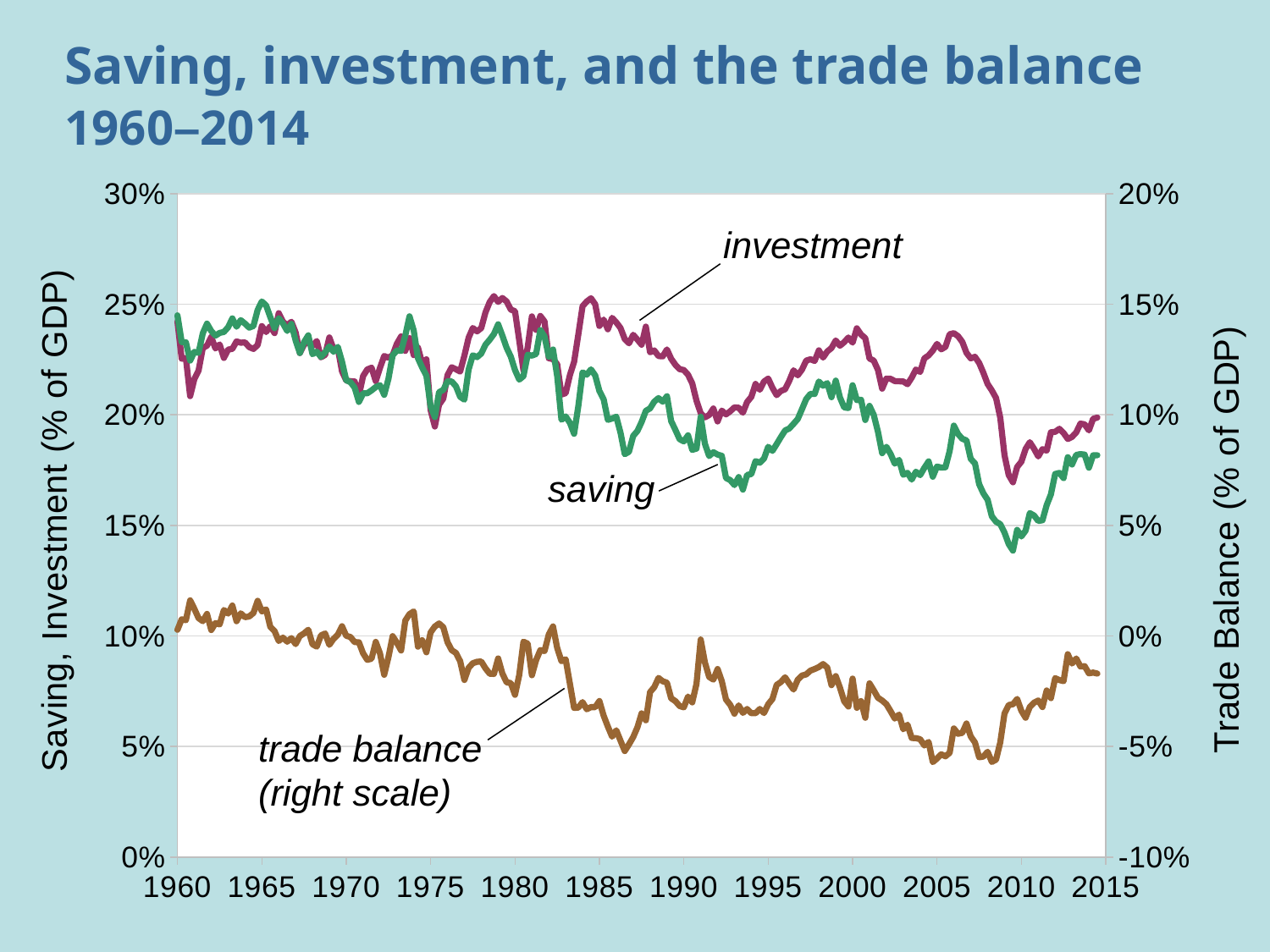
Does the saving series overall rise or fall from 1960 to 2014? fall Which series is plotted against the right scale? trade balance How many series are plotted on the chart? 3 Is the value for trade balance in 1965 greater or less than 0%? greater Is the value for investment in 1960 greater or less than 20%? greater In 2000, which is higher, investment or saving? investment What kind of chart is shown on the slide? line chart What is the title of the chart? Saving, investment, and the trade balance 1960–2014 Is the value for trade balance in 2005 greater or less than 0%? less Does the trade balance series overall rise or fall from 1960 to 2005? fall